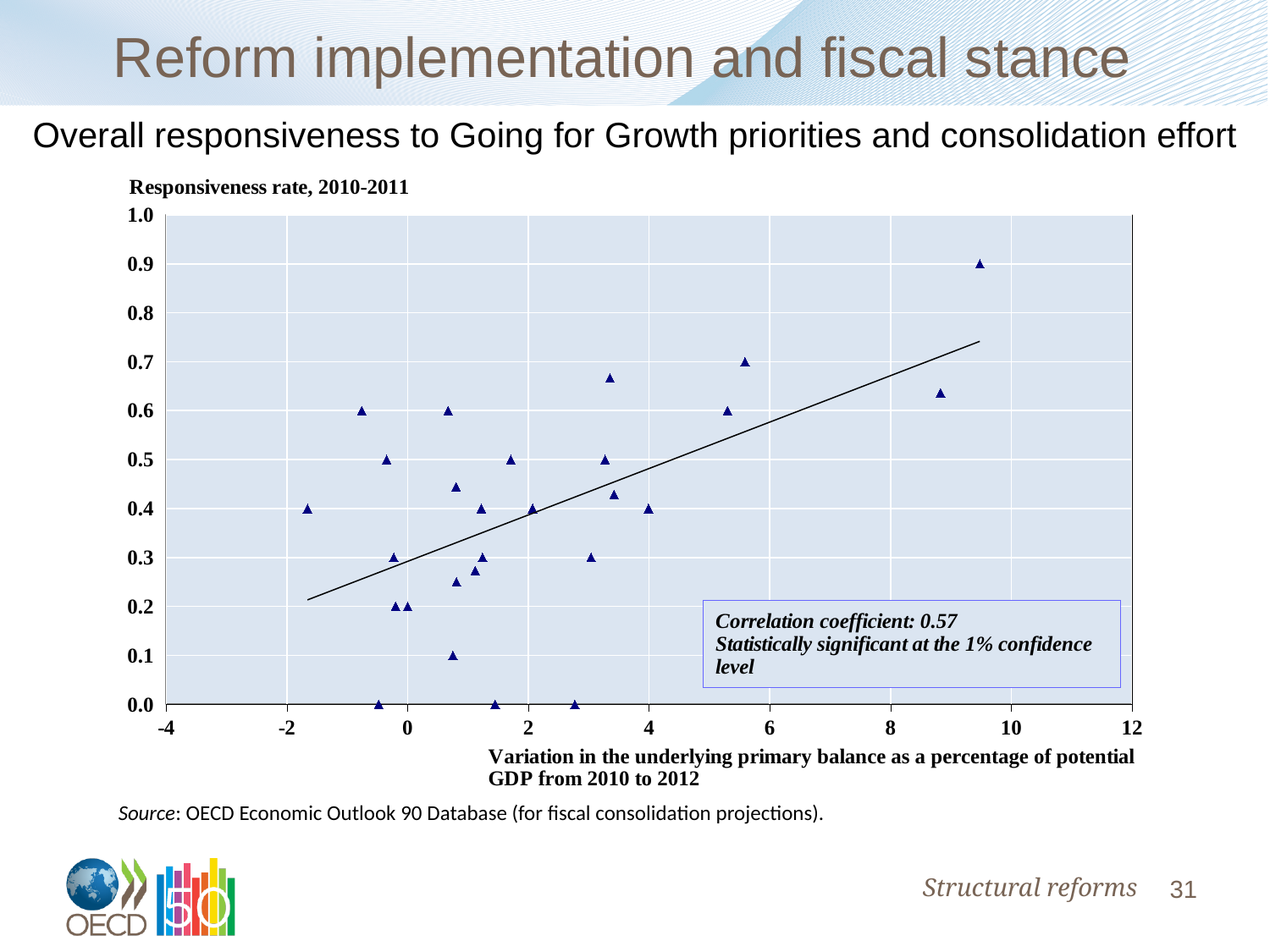
What is the lowest responsiveness rate plotted on the chart? 0.0 Is the responsiveness rate of the highest point on the chart greater or less than 0.8? greater Is the responsiveness rate of the leftmost point on the chart greater or less than 0.5? less What kind of chart is shown on the slide? scatter chart What correlation coefficient is reported in the text box on the chart? 0.57 Does the fitted trend line rise or fall as the variation in the underlying primary balance increases? rises What is the label on the vertical axis of the chart? Responsiveness rate, 2010-2011 What is the highest responsiveness rate plotted on the chart? 0.9 Is the responsiveness rate of the rightmost point on the chart greater or less than 0.8? greater What is the maximum value shown on the horizontal axis? 12 What is the minimum value shown on the horizontal axis? -4